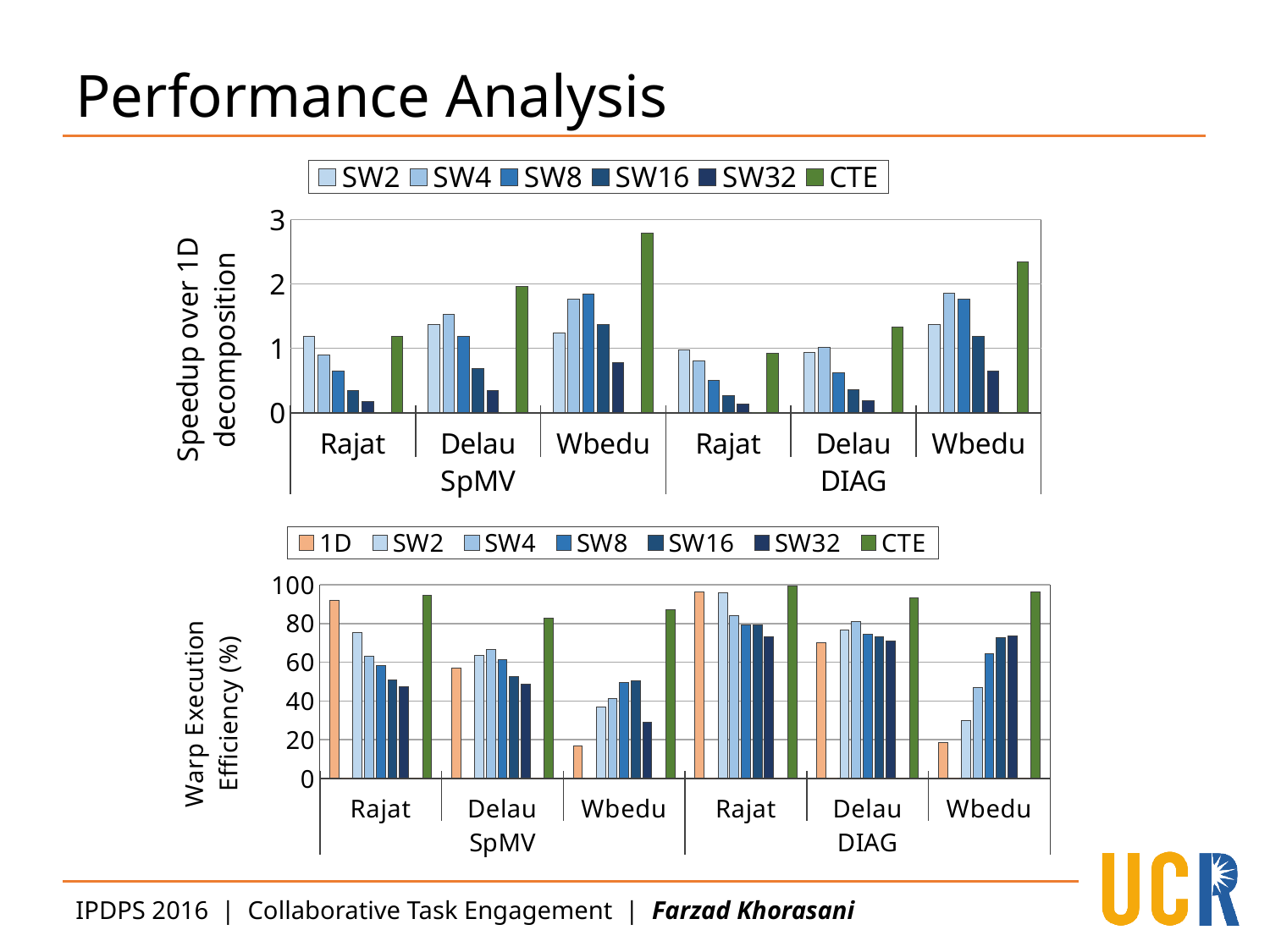
In the top chart (Speedup over 1D decomposition), is the SW32 value for Rajat under DIAG greater or less than 1? less In the bottom chart (Warp Execution Efficiency), is the 1D value for Wbedu under SpMV greater or less than 20? less In the bottom chart (Warp Execution Efficiency), which is larger: the 1D value for Rajat under SpMV or the 1D value for Wbedu under SpMV? Rajat under SpMV What kind of chart is the top chart (Speedup over 1D decomposition)? bar chart In the top chart (Speedup over 1D decomposition), which series has the highest bar for Wbedu under SpMV? CTE In the top chart (Speedup over 1D decomposition), is the CTE value for Wbedu under SpMV greater or less than 2? greater In the top chart (Speedup over 1D decomposition), which is larger: the CTE value for Wbedu under SpMV or the CTE value for Wbedu under DIAG? Wbedu under SpMV In the top chart (Speedup over 1D decomposition), how many category groups are shown along the x axis? 6 In the top chart (Speedup over 1D decomposition), for Rajat under SpMV, do the bars rise or fall from SW2 to SW32? fall How many series does the legend of the bottom chart (Warp Execution Efficiency) list? 7 In the bottom chart (Warp Execution Efficiency), which series is shown in orange in the legend? 1D How many series does the legend of the top chart (Speedup over 1D decomposition) list? 6